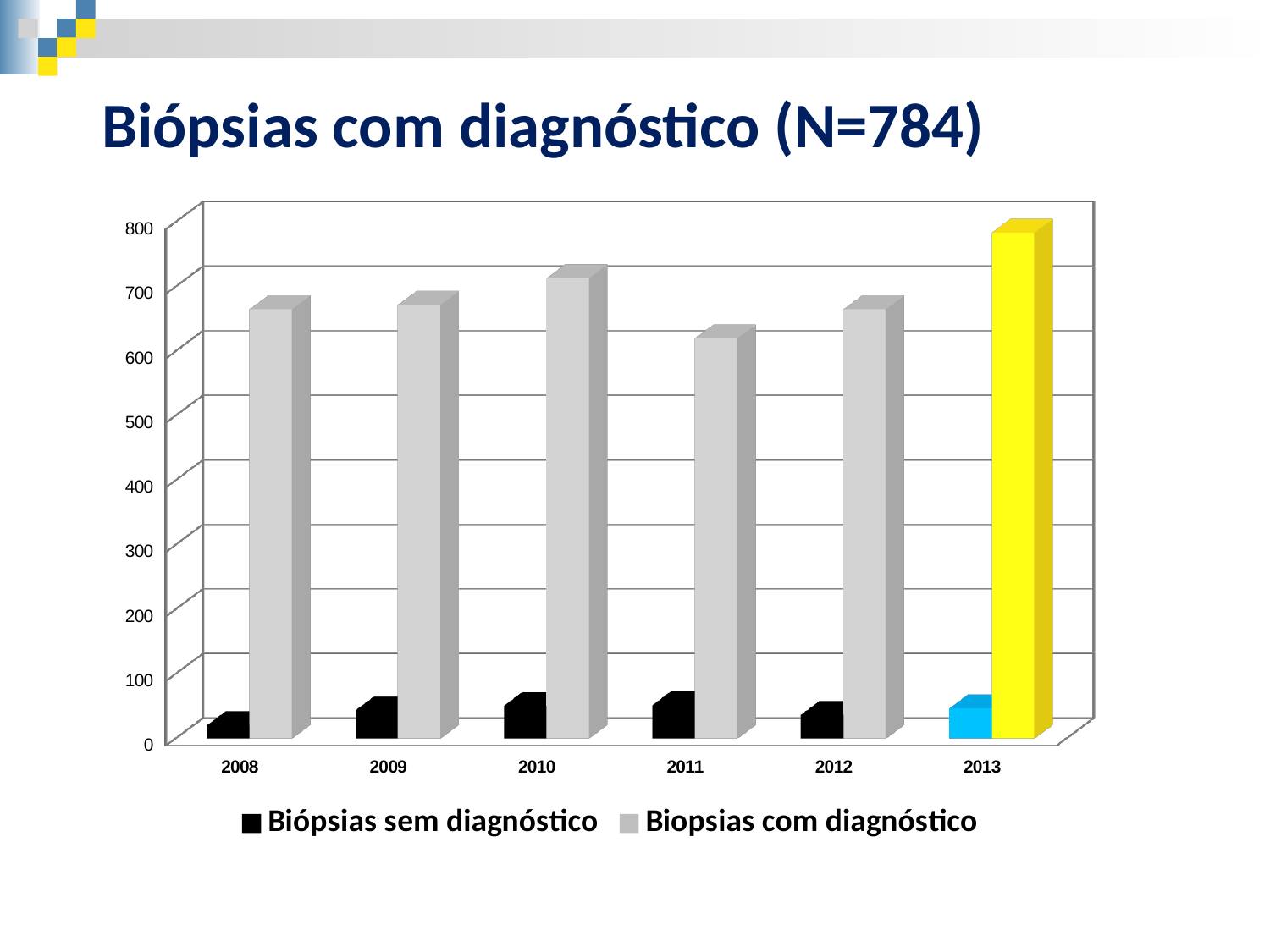
What is the title of the slide? Biópsias com diagnóstico (N=784) How many years are shown on the x axis of the chart? 6 What kind of chart is shown on the slide? bar chart Is the value for Biopsias com diagnóstico in 2011 greater or less than 700? less Which year has the lowest value for Biopsias com diagnóstico? 2011 Which year has the highest value for Biopsias com diagnóstico? 2013 Which year has the lowest value for Biópsias sem diagnóstico? 2008 Is the value for Biópsias sem diagnóstico in 2008 greater or less than 100? less How many series does the chart legend list? 2 Which is larger, the Biopsias com diagnóstico value for 2010 or for 2011? 2010 Is the value for Biopsias com diagnóstico in 2013 greater or less than 700? greater What colour is the Biopsias com diagnóstico bar for 2013? yellow